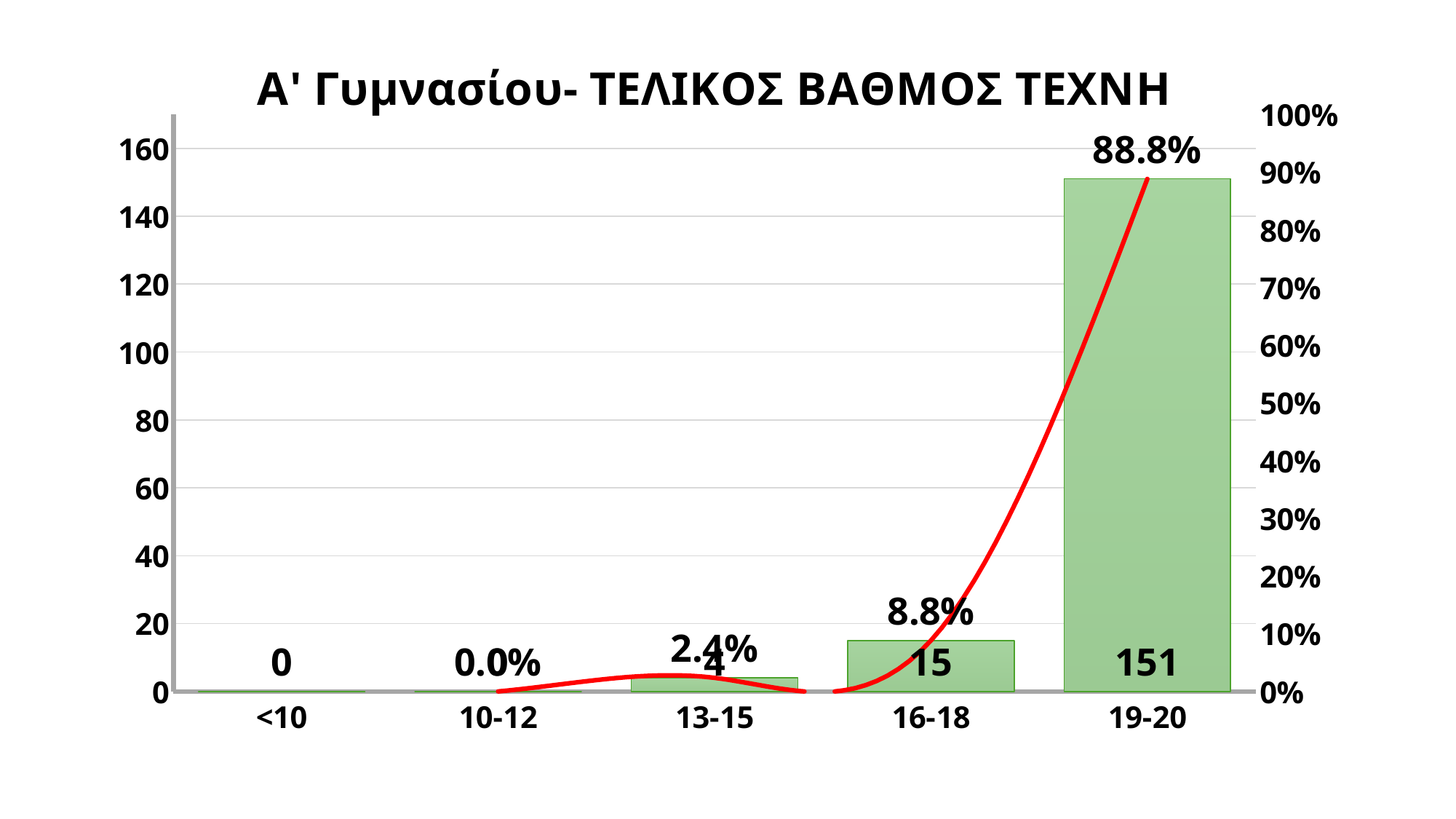
How many categories are shown on the x axis? 5 What is the title of the chart? Α' Γυμνασίου- ΤΕΛΙΚΟΣ ΒΑΘΜΟΣ ΤΕΧΝΗ What is the value of the bar for the 19-20 category? 151 What is the value of the bar for the 13-15 category? 4 Is the bar value for 19-20 greater or less than 140? greater What is the value of the bar for the 16-18 category? 15 What percentage is labelled for the 13-15 category? 2.4% Which category has the highest bar? 19-20 What percentage is labelled for the 16-18 category? 8.8% What percentage is labelled for the 19-20 category? 88.8% Which category has the larger bar, 13-15 or 16-18? 16-18 What is the difference between the bar values for 19-20 and 16-18? 136